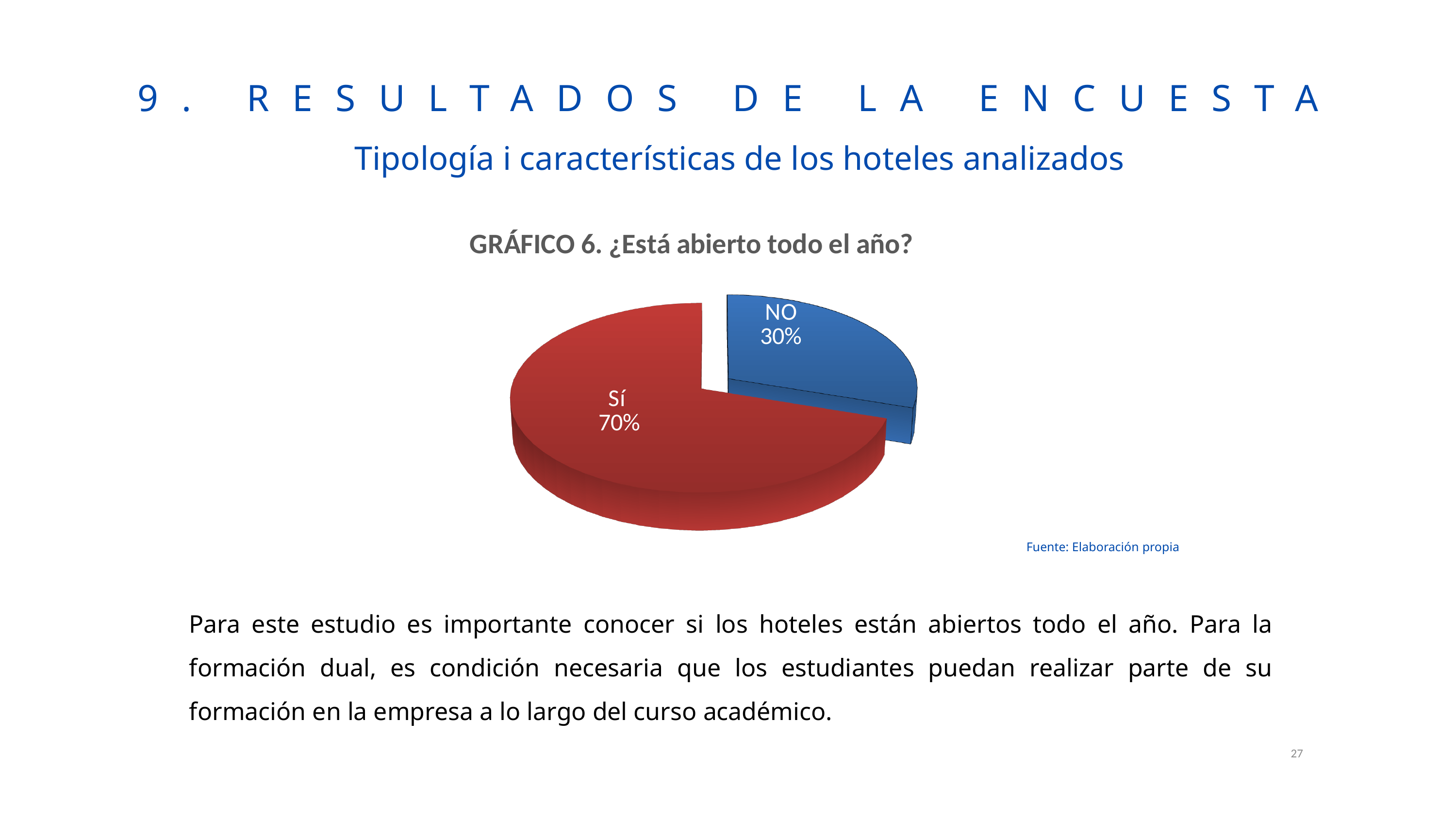
What is the difference in percentage points between the "Sí" and "NO" slices? 40 Which slice of the pie is the smallest? NO What share of the pie does the "NO" slice represent? 30% What kind of chart is shown on the slide? Pie chart What percentage of hotels answered "NO" to being open all year? 30% What is the title of the chart? GRÁFICO 6. ¿Está abierto todo el año? Which is larger, the "Sí" slice or the "NO" slice? Sí What percentage of hotels answered "Sí" to being open all year? 70% What colour is the "Sí" slice of the pie? Red How many slices does the pie chart have? 2 Which slice of the pie is the largest? Sí